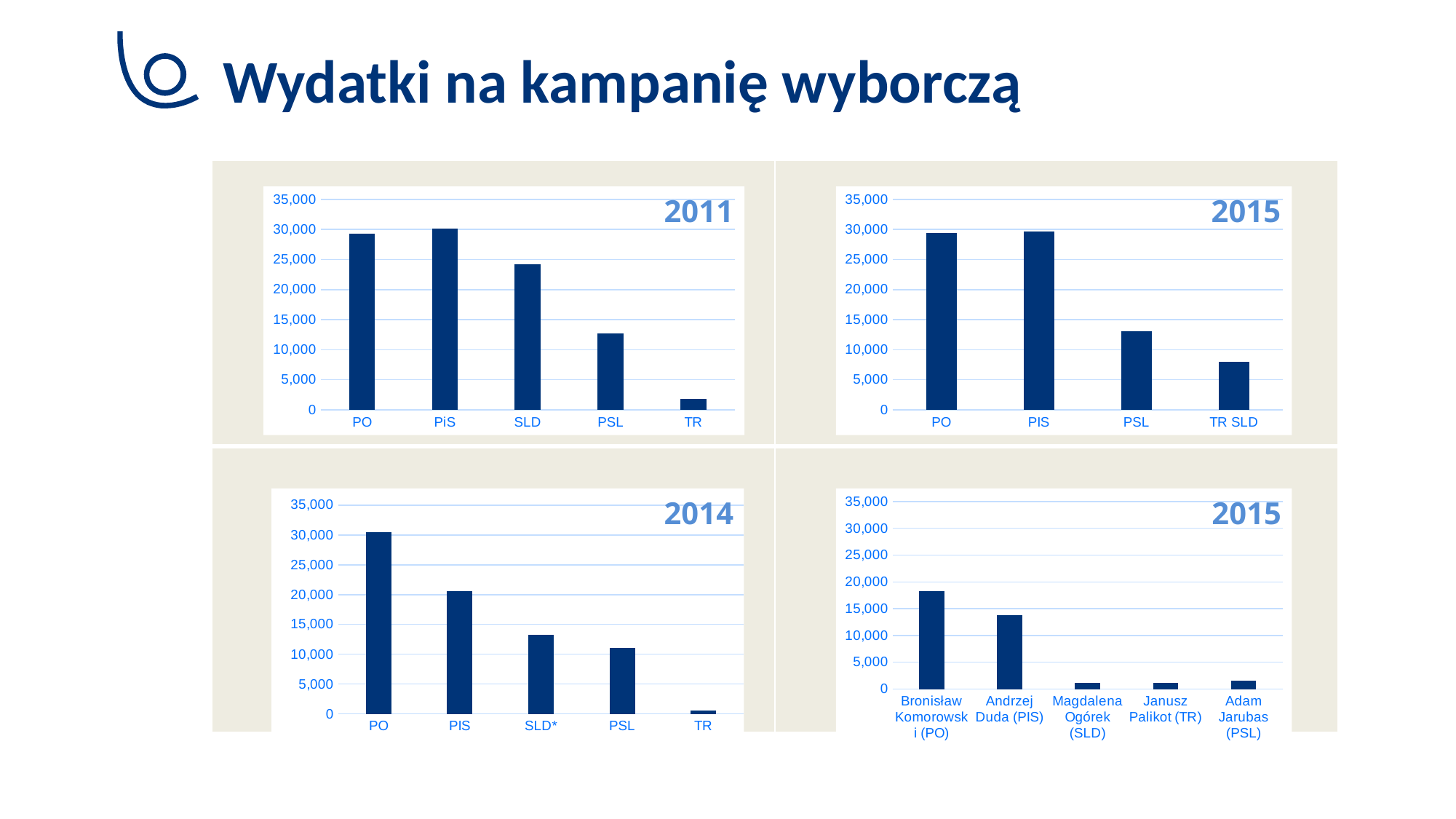
In the 2011 chart (top-left), which category has the lowest value? TR In the 2015 chart at the top-right, is the value for PSL greater or less than 10,000? greater In the 2015 chart at the top-right, which category has the lowest value? TR SLD In the 2011 chart (top-left), is the value for PSL greater or less than 15,000? less In the 2015 chart at the top-right, which is larger, PSL or TR SLD? PSL In the 2015 chart at the bottom-right, which category has the highest value? Bronisław Komorowski (PO) In the 2011 chart (top-left), is the value for SLD greater or less than 20,000? greater In the 2014 chart (bottom-left), which category has the highest value? PO In the 2011 chart (top-left), how many categories are shown on the x axis? 5 What kind of chart is the 2015 chart at the bottom-right? bar chart In the 2014 chart (bottom-left), do the values rise or fall from left to right along the x axis? fall